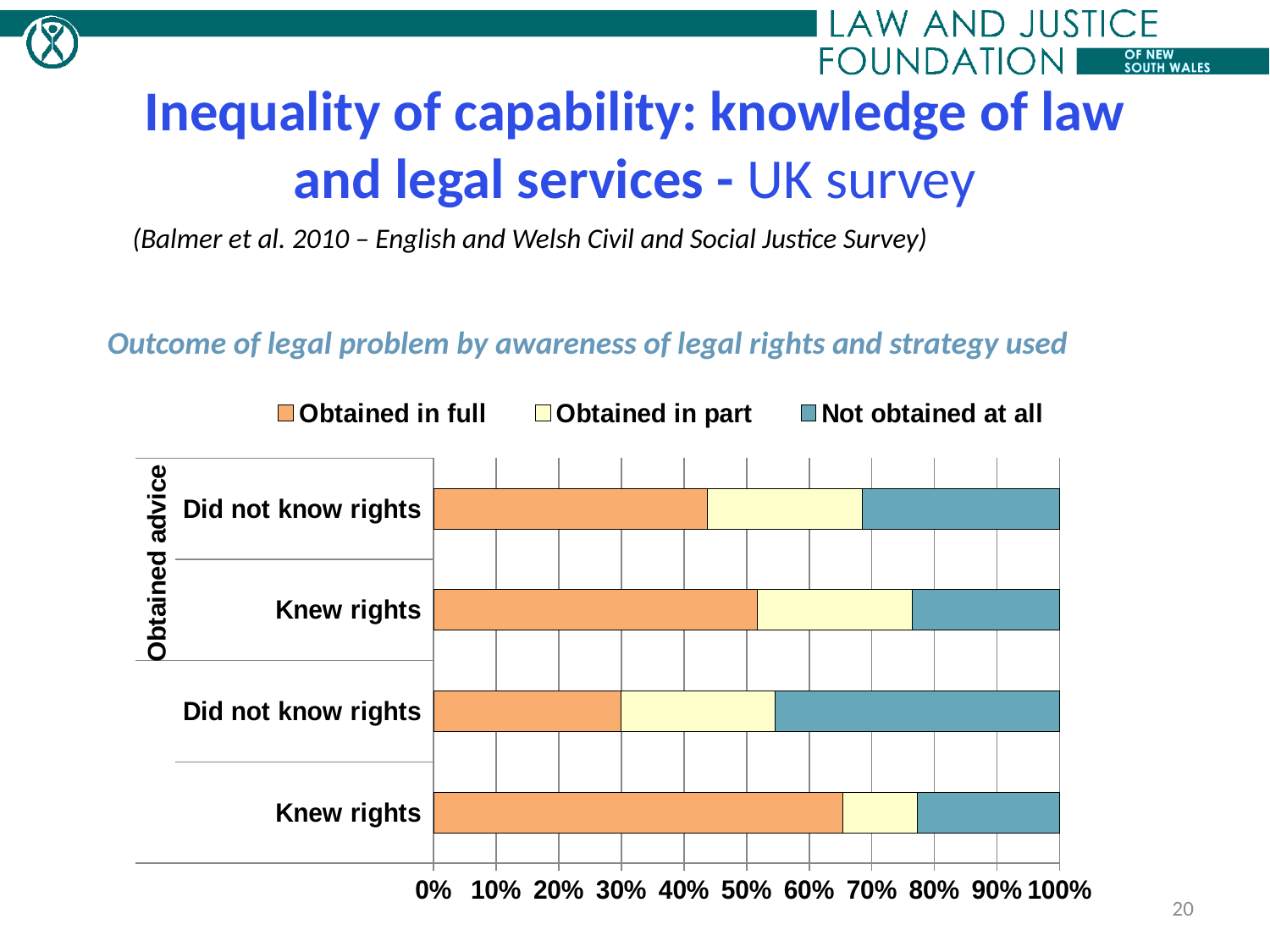
What kind of chart is shown on the slide? stacked bar chart Is the 'Obtained in full' share for 'Knew rights' in the 'Obtained advice' group greater or less than 50%? greater Which bar has the largest 'Not obtained at all' share? Did not know rights (third bar from top) Is the 'Obtained in full' share for the lower 'Did not know rights' bar (third from top) greater or less than 40%? less What is the subtitle of the chart? Outcome of legal problem by awareness of legal rights and strategy used How many series does the legend list? 3 What are the three outcome categories listed in the legend? Obtained in full, Obtained in part, Not obtained at all Is the 'Obtained in full' share for 'Did not know rights' in the 'Obtained advice' group greater or less than 40%? greater Which bar has the largest 'Obtained in full' share? Knew rights (bottom bar) How many bars are plotted in the chart? 4 Within the 'Obtained advice' group, which has the larger 'Obtained in full' share: 'Knew rights' or 'Did not know rights'? Knew rights